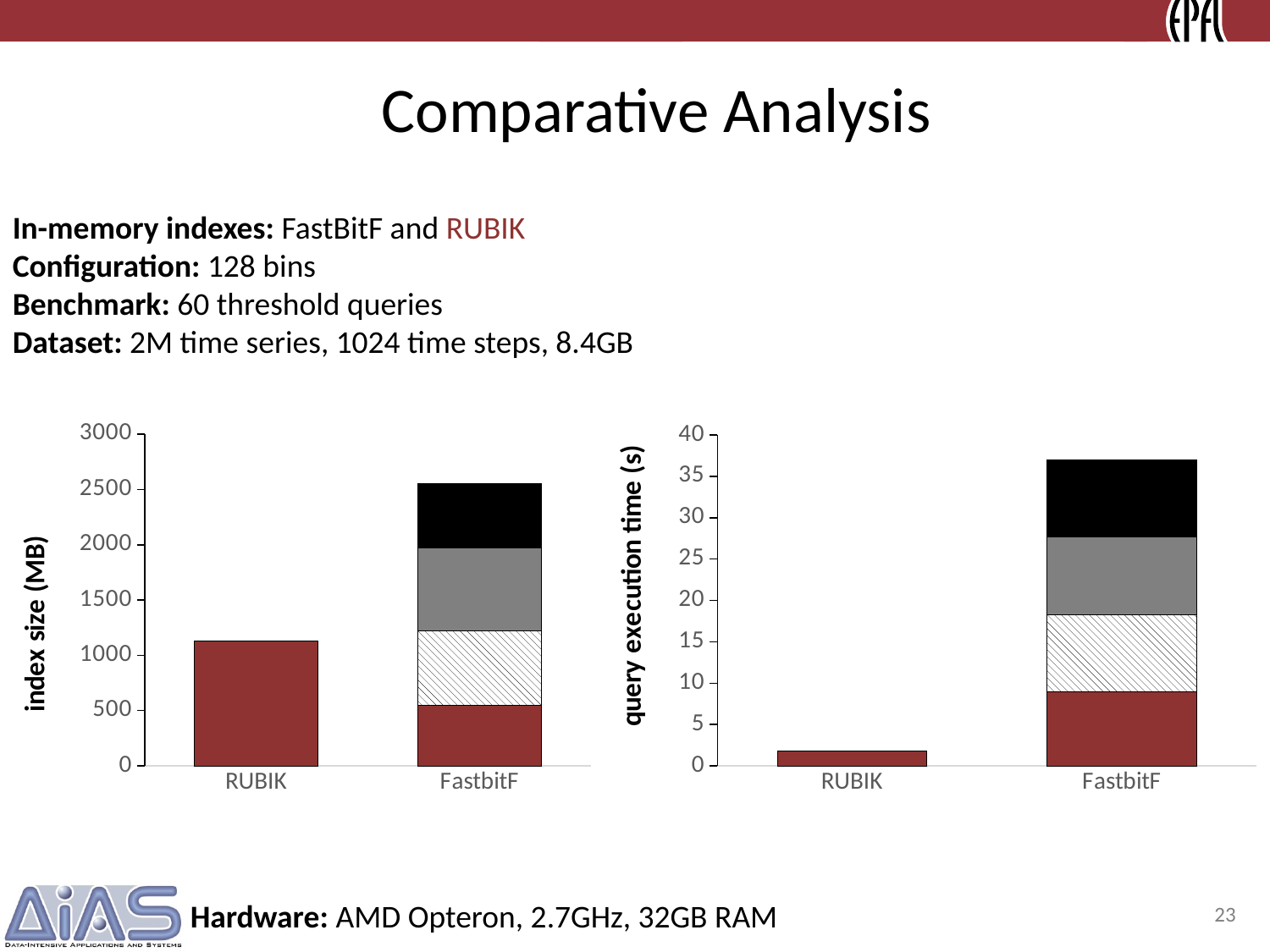
In the right chart (query execution time), is the value for RUBIK greater or less than 5? less What is the y-axis title of the left chart? index size (MB) What kind of chart is the right chart (query execution time)? bar chart In the left chart (index size), how many categories are shown on the x axis? 2 In the right chart (query execution time), how many categories are shown on the x axis? 2 In the left chart (index size), is the total for FastbitF greater or less than 2000? greater What kind of chart is the left chart (index size)? bar chart In the left chart (index size), is the value for RUBIK greater or less than 1500? less In the left chart (index size), which category has the larger total index size? FastbitF In the right chart (query execution time), which category has the lowest query execution time? RUBIK